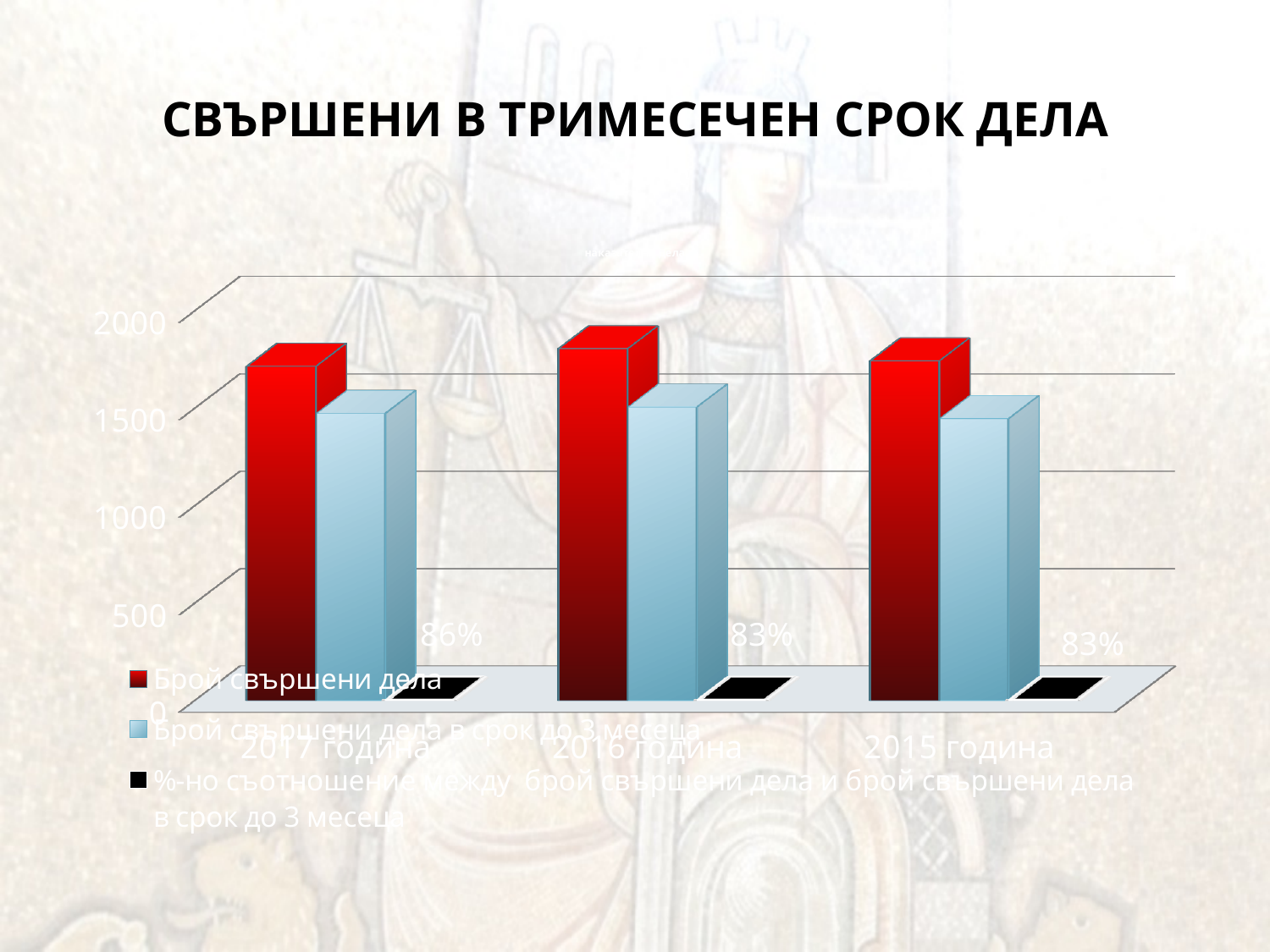
What is the percentage value shown for 2017 година? 86% How many year categories are shown on the x axis? 3 How many series does the legend list? 3 What type of chart is shown on the slide? bar chart What is the difference between the percentage values for 2017 година and 2016 година? 3% Is the value of Брой свършени дела в срок до 3 месеца for 2015 година greater or less than 1000? greater What is the percentage value shown for 2016 година? 83% What is the percentage value shown for 2015 година? 83% In 2016 година, which is larger: Брой свършени дела or Брой свършени дела в срок до 3 месеца? Брой свършени дела Is the value of Брой свършени дела for 2017 година greater or less than 1500? greater Is the percentage value for 2017 година larger or smaller than that for 2015 година? larger Which year has the highest percentage value? 2017 година